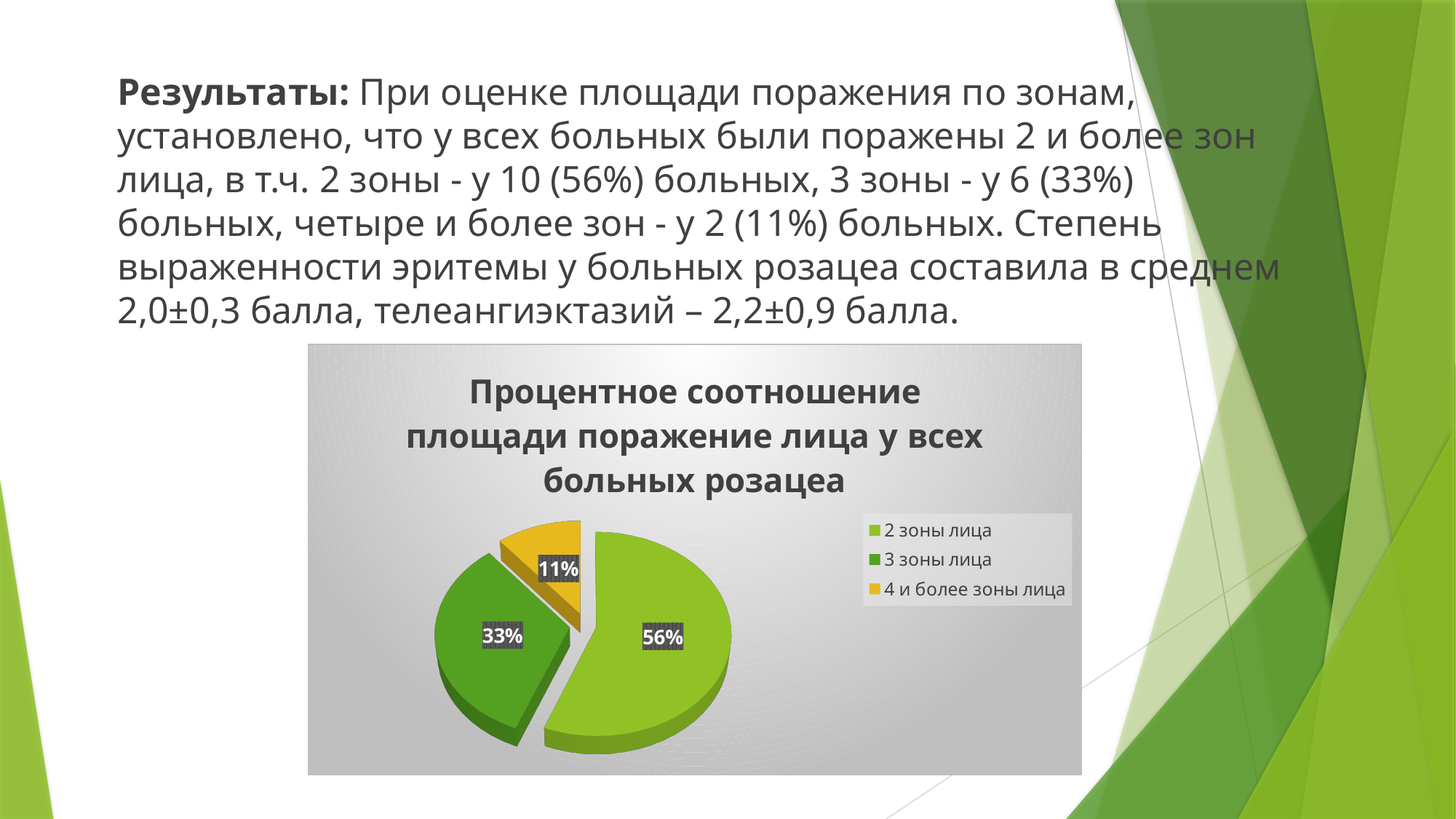
Which category has the smallest slice of the pie chart? 4 и более зоны лица What is the difference in percentage points between the "2 зоны лица" and "3 зоны лица" slices? 23 What is the share for "4 и более зоны лица" in the pie chart? 11% What is the share for "3 зоны лица" in the pie chart? 33% Which category has the largest slice of the pie chart? 2 зоны лица What colour is the slice for "4 и более зоны лица"? yellow What kind of chart is shown on the slide? pie chart What is the title of the pie chart? Процентное соотношение площади поражение лица у всех больных розацеа Which slice is larger: "3 зоны лица" or "4 и более зоны лица"? 3 зоны лица How many categories does the pie chart have? 3 What is the share for "2 зоны лица" in the pie chart? 56% What is the difference in percentage points between the "3 зоны лица" and "4 и более зоны лица" slices? 22